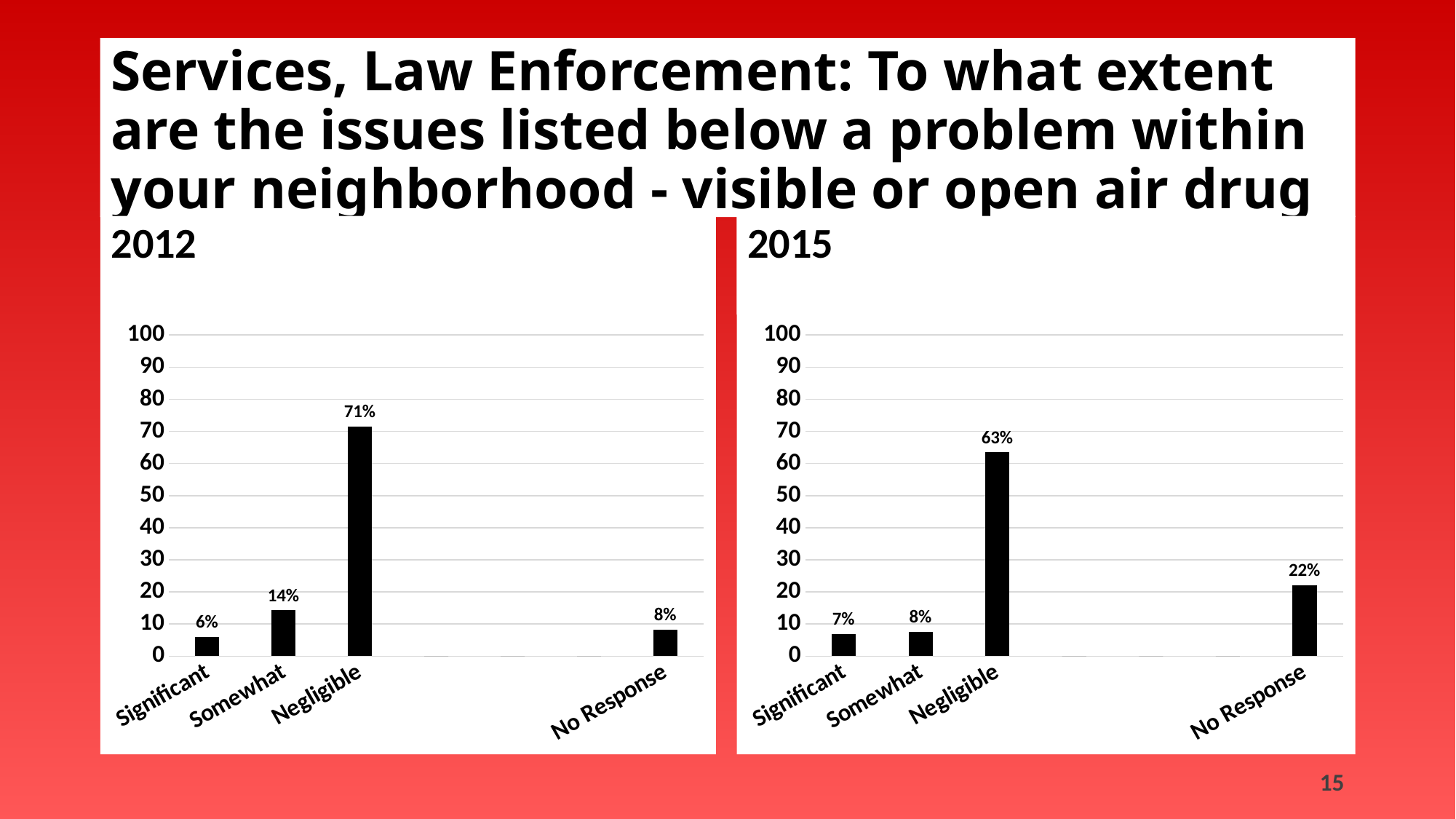
In the 2015 chart, what is the value for Significant? 7% How many labelled categories are shown on the x axis of the 2012 chart? 4 In the 2012 chart, which category has the highest value? Negligible In the 2012 chart, what is the value for Negligible? 71% In the 2012 chart, what is the value for Somewhat? 14% What type of chart is the 2015 chart? bar chart In the 2015 chart, what is the value for No Response? 22% In the 2012 chart, which is larger, Somewhat or No Response? Somewhat In the 2015 chart, which category has the lowest value? Significant In the 2015 chart, is the value for Negligible greater or less than 50? greater In the 2012 chart, which category has the lowest value? Significant In the 2015 chart, what is the difference between Negligible and No Response? 41%